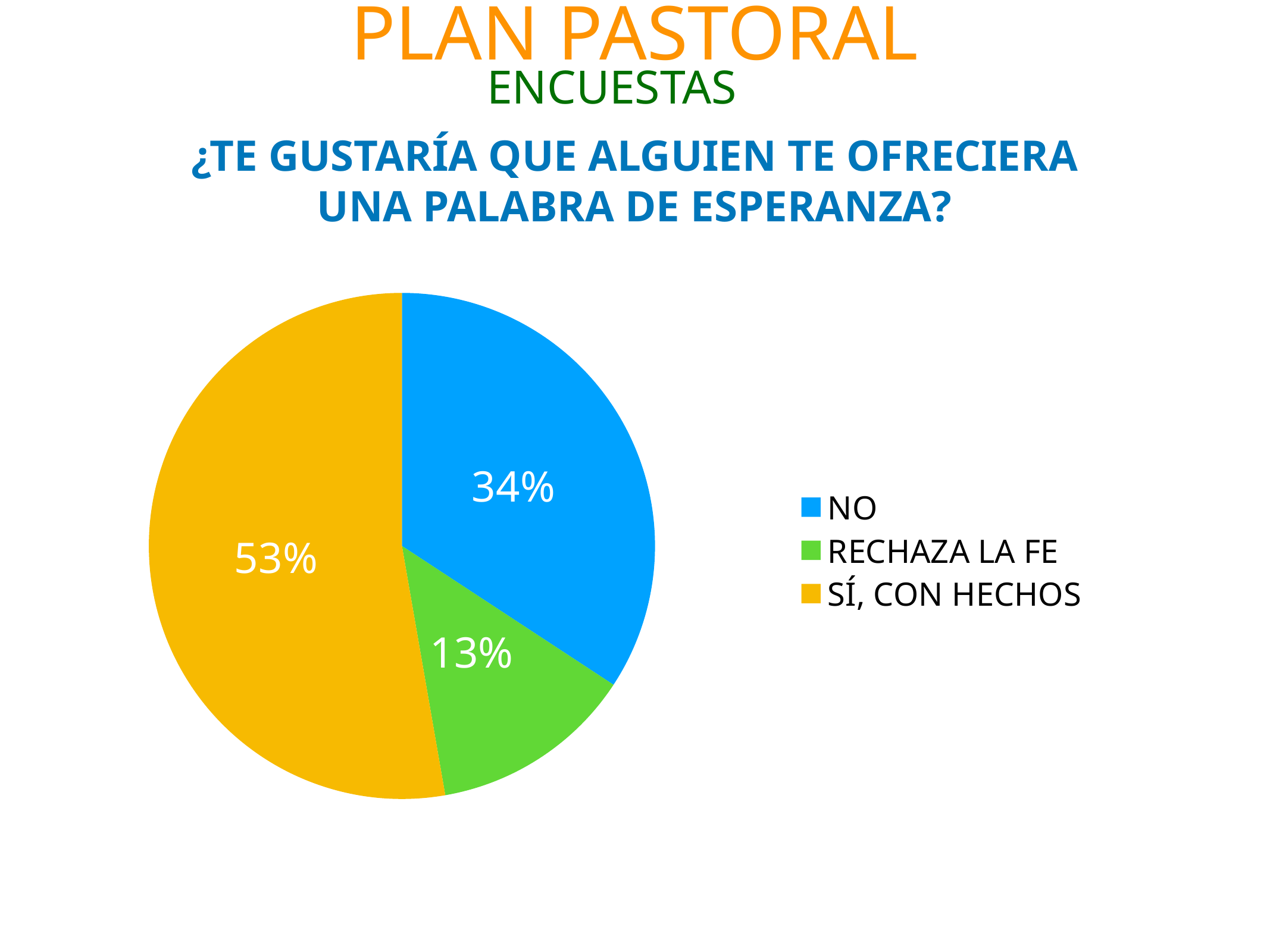
What colour is the slice for SÍ, CON HECHOS? yellow/orange What is the difference in percentage points between NO and RECHAZA LA FE? 21 Which is larger, the share for NO or the share for RECHAZA LA FE? NO What percentage of the pie is labelled SÍ, CON HECHOS? 53% What is the difference in percentage points between SÍ, CON HECHOS and NO? 19 Which category has the smallest share of the pie? RECHAZA LA FE What percentage of the pie is labelled NO? 34% What percentage of the pie is labelled RECHAZA LA FE? 13% What question does the chart's title ask? ¿TE GUSTARÍA QUE ALGUIEN TE OFRECIERA UNA PALABRA DE ESPERANZA? Which category has the largest share of the pie? SÍ, CON HECHOS How many categories does the pie chart have? 3 What kind of chart is shown on the slide? pie chart